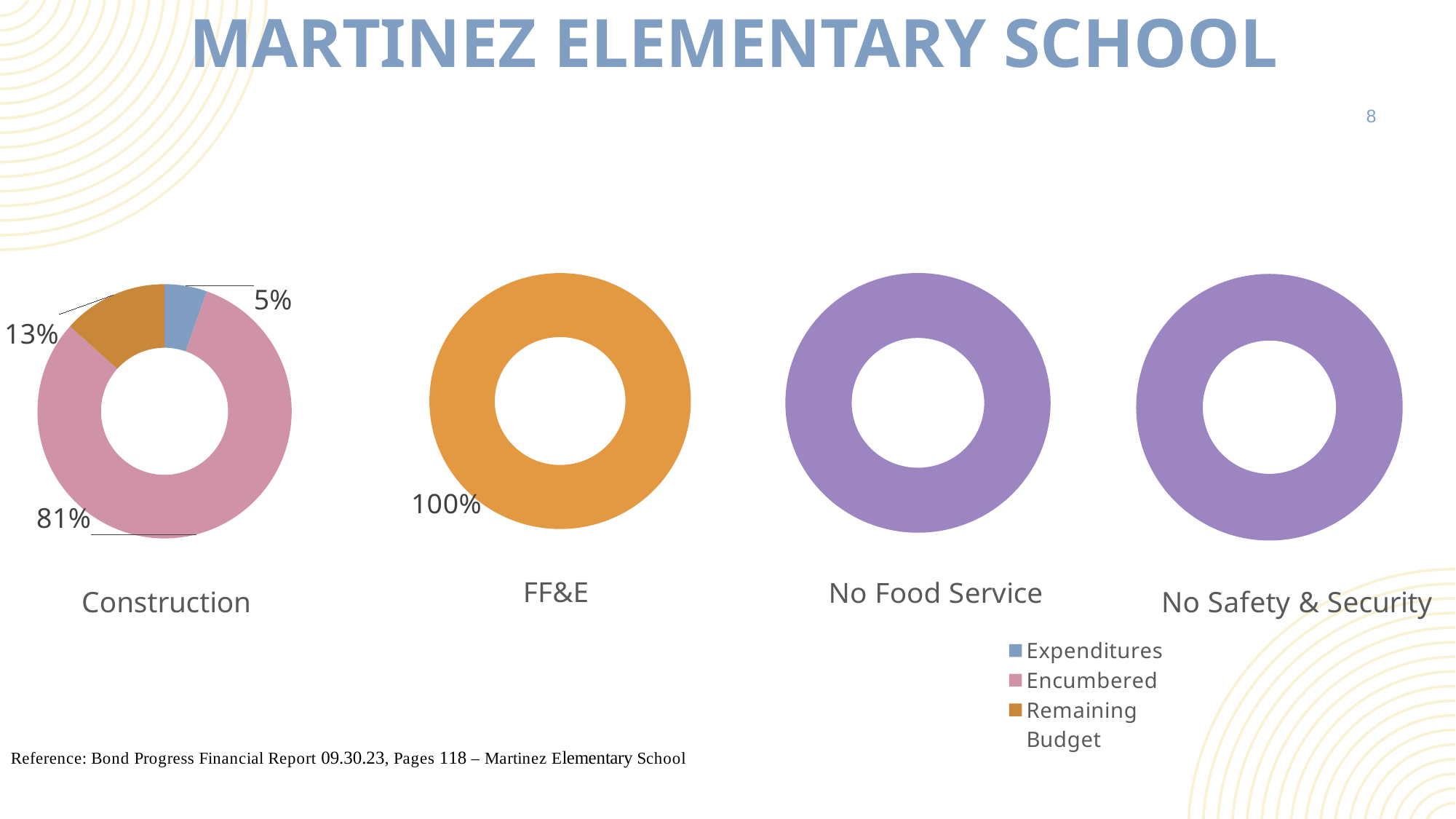
In the Construction chart, what percentage is Encumbered? 81% In the Construction chart, which category has the smallest share? Expenditures What is the label of the chart furthest to the right on the slide? No Safety & Security In the Construction chart, what is the difference between the Encumbered share and the Remaining Budget share? 68% In the Construction chart, which category has the largest share? Encumbered In the FF&E chart, what percentage is Remaining Budget? 100% How many donut charts are shown on the slide? 4 What kind of chart is the Construction chart? Donut chart In the Construction chart, which is larger, Remaining Budget or Expenditures? Remaining Budget How many series does the legend list? 3 In the Construction chart, what percentage is Remaining Budget? 13% In the Construction chart, what percentage is Expenditures? 5%